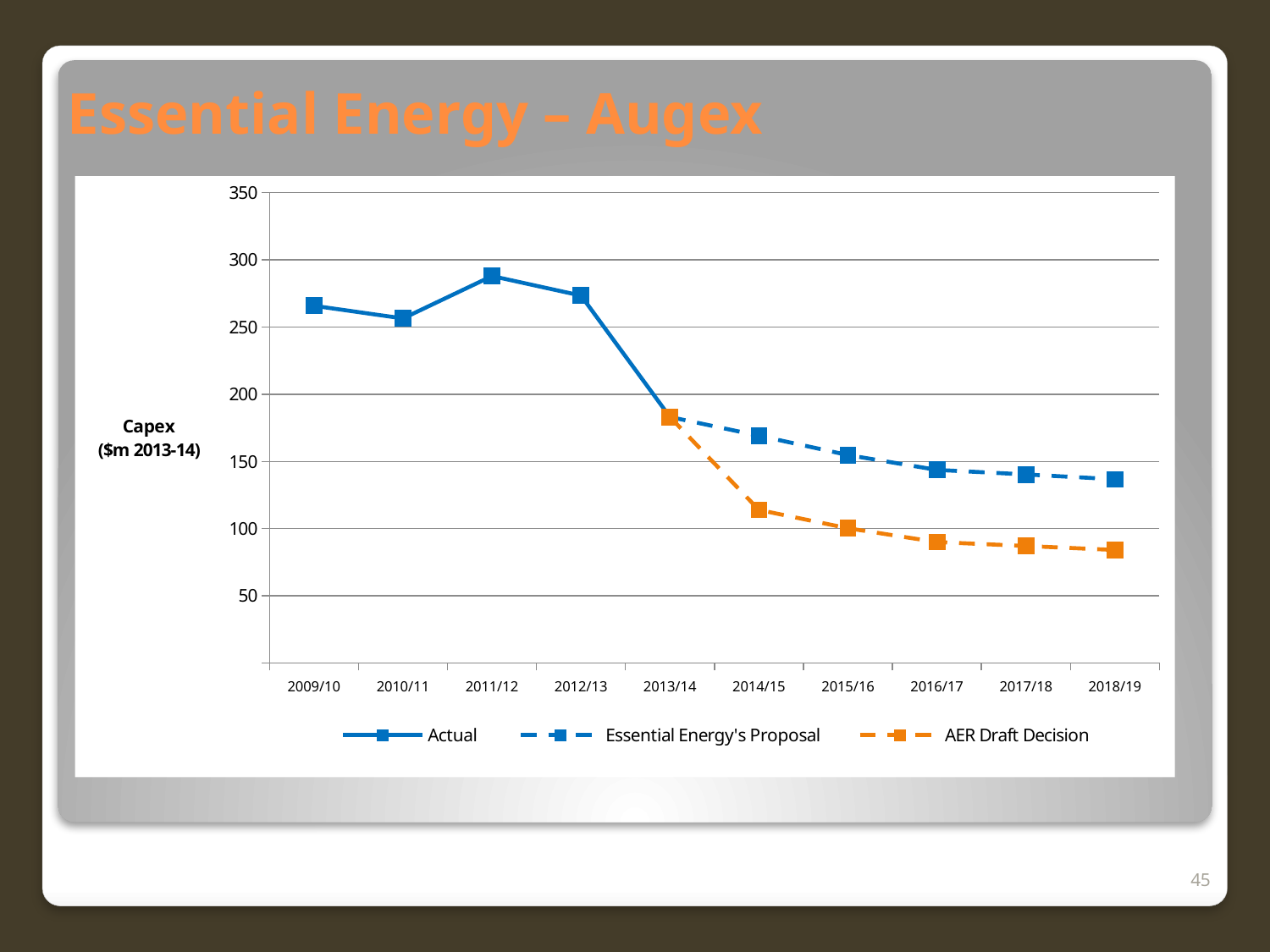
Is the Actual value for 2011/12 greater or less than 250? greater Is the AER Draft Decision value for 2018/19 greater or less than 100? less How many series does the legend list? 3 In 2016/17, which is larger: Essential Energy's Proposal or the AER Draft Decision? Essential Energy's Proposal Is the Essential Energy's Proposal value for 2018/19 greater or less than 150? less In which year does the Actual series reach its highest value? 2011/12 What kind of chart is shown on the slide? line chart Does the AER Draft Decision series rise or fall from 2013/14 to 2018/19? fall In which year is the AER Draft Decision series at its lowest value? 2018/19 What is the label on the vertical axis of the chart? Capex ($m 2013-14) How many years are shown along the x axis? 10